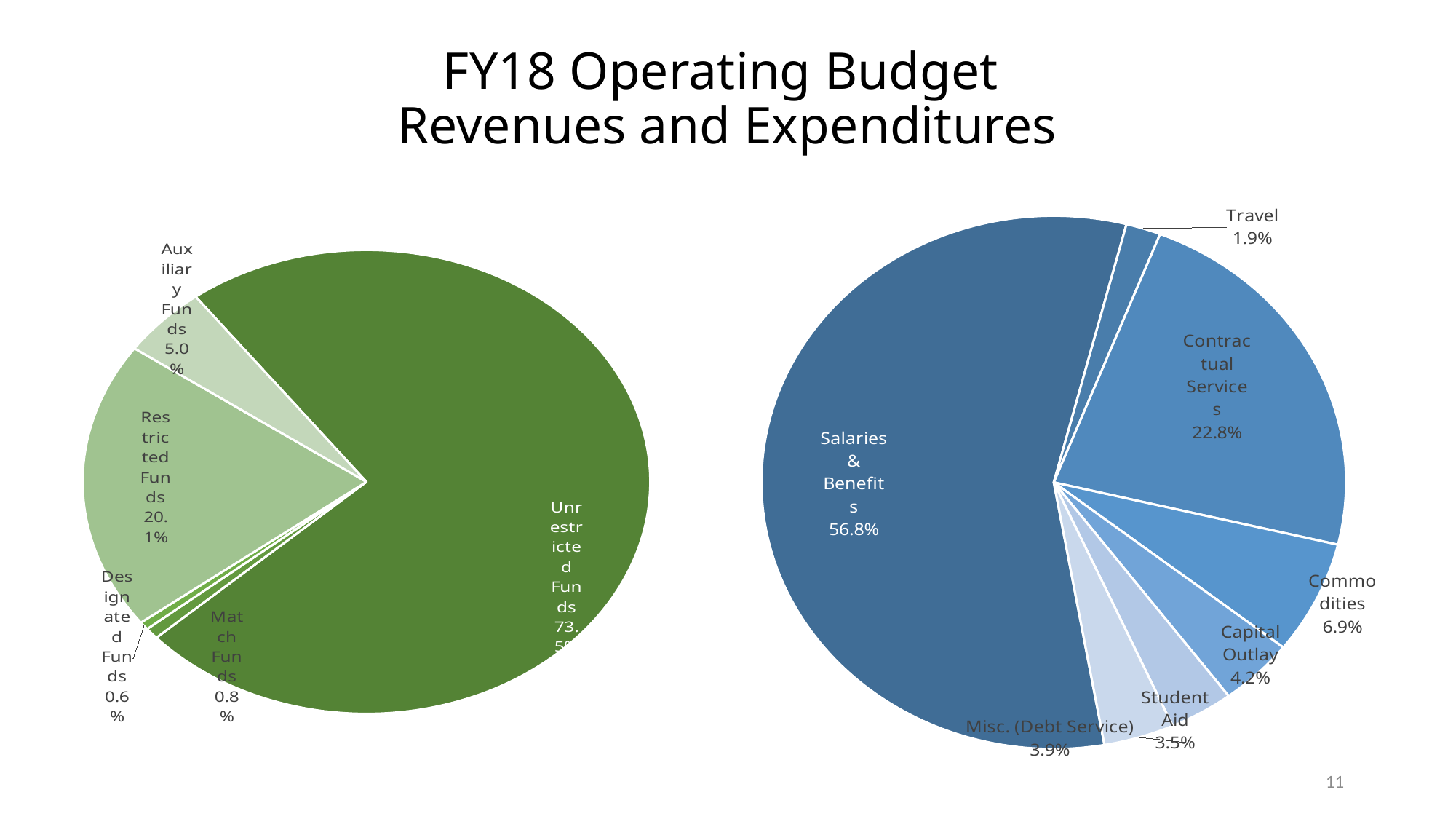
In the left pie chart, what share do Auxiliary Funds represent? 5.0% In the right pie chart, what share does Capital Outlay represent? 4.2% In the left pie chart, which category has the smallest slice? Designated Funds In the left pie chart, how many slices are there? 5 In the left pie chart, which category has the largest slice? Unrestricted Funds In the right pie chart, which is larger, Misc. (Debt Service) or Student Aid? Misc. (Debt Service) In the right pie chart, which category has the smallest slice? Travel In the right pie chart, what share do Salaries & Benefits represent? 56.8% What type of charts are shown on the slide? Pie charts In the right pie chart, how many slices are there? 7 In the left pie chart, what share do Restricted Funds represent? 20.1% In the right pie chart, what is the difference between Contractual Services and Commodities? 15.9%